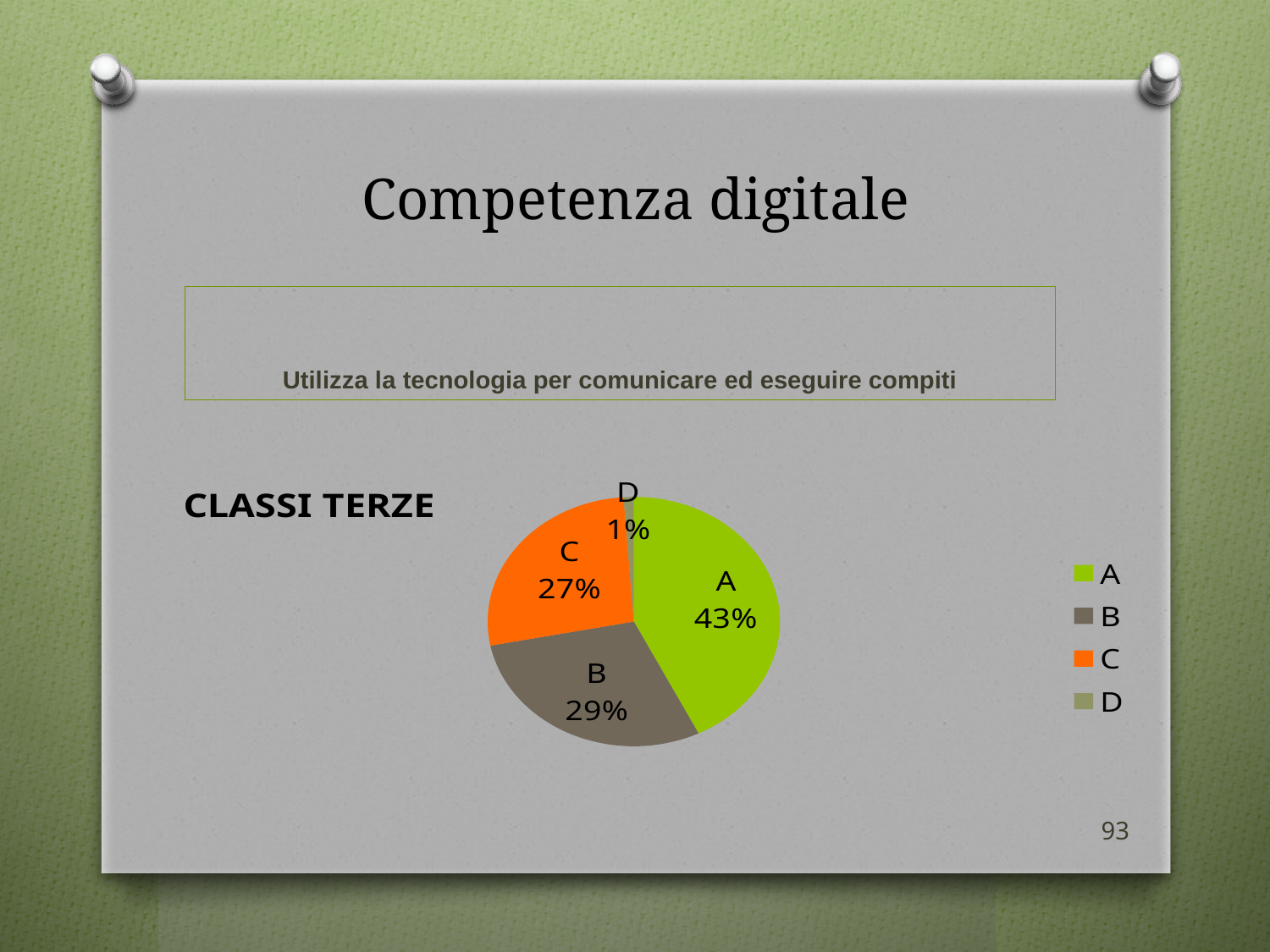
What kind of chart is shown on the slide? pie chart What percentage of the pie does slice C represent? 27% How many entries does the legend list? 4 Which slice of the pie is the largest? A Which slice of the pie is the smallest? D How many slices does the pie chart have? 4 What percentage of the pie does slice D represent? 1% What colour is slice C in the pie chart? orange Which is larger, slice A or slice C? A What percentage of the pie does slice A represent? 43% What is the difference in percentage points between slice A and slice B? 14 What percentage of the pie does slice B represent? 29%